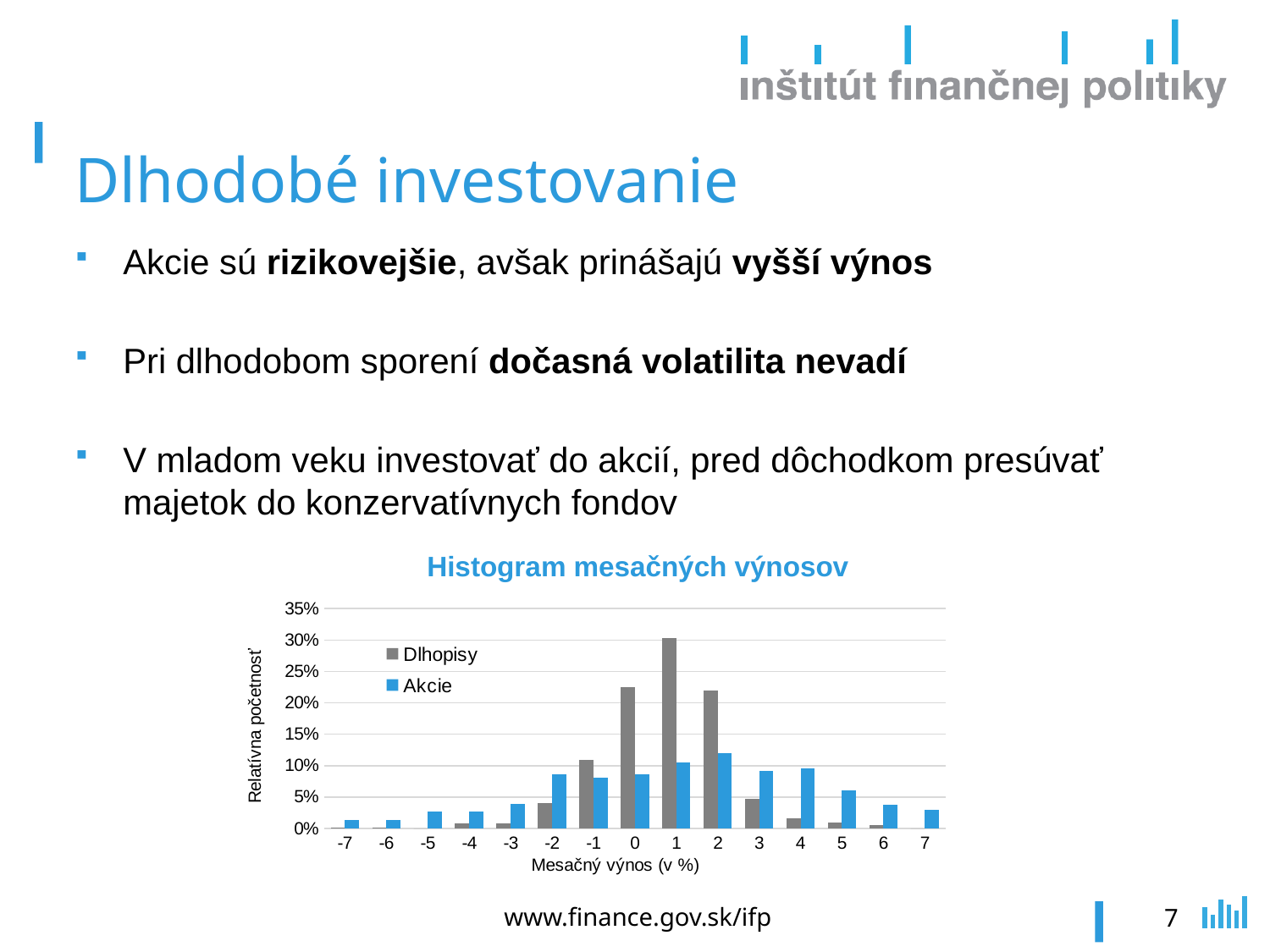
What kind of chart is shown under the title "Histogram mesačných výnosov"? bar chart How many series does the legend of the histogram list? 2 At a monthly return of 0, which series has the larger bar, Dlhopisy or Akcie? Dlhopisy What is the label of the vertical axis of the histogram? Relatívna početnosť How many monthly return categories are shown on the x axis of the histogram? 15 Is the Dlhopisy value at a monthly return of -1 greater or less than 5%? greater At which monthly return (Mesačný výnos) does the Akcie series reach its highest bar? 2 At which monthly return (Mesačný výnos) does the Dlhopisy series reach its highest bar? 1 Is the Dlhopisy value at a monthly return of 1 greater or less than 25%? greater What are the two series named in the legend of the histogram? Dlhopisy and Akcie Is the Akcie value at a monthly return of 2 greater or less than 15%? less At a monthly return of -2, which series has the larger bar, Dlhopisy or Akcie? Akcie